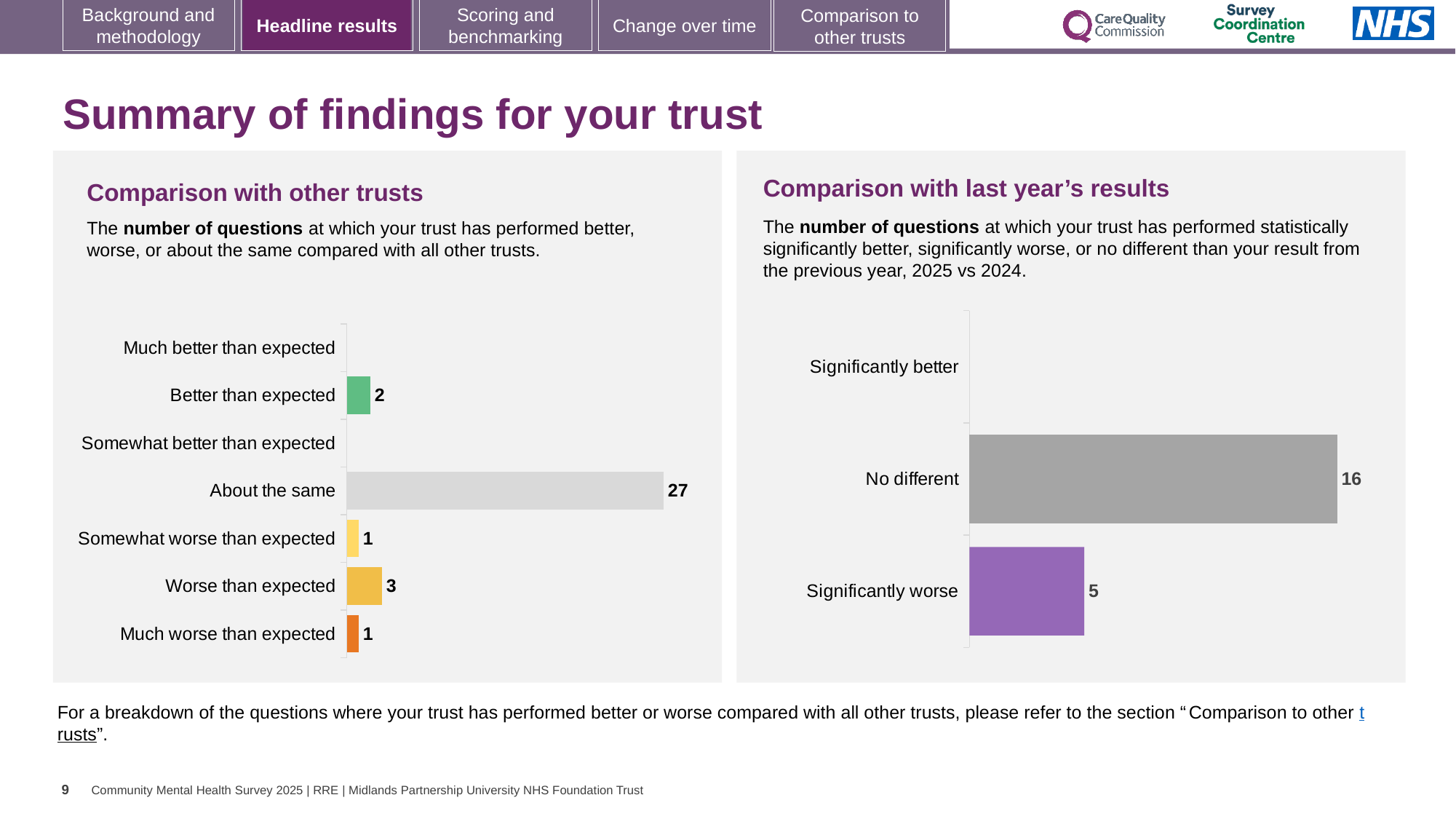
In the 'Comparison with last year's results' chart, what is the value for 'Significantly worse'? 5 In the 'Comparison with other trusts' chart, which category has the highest value? About the same In the 'Comparison with other trusts' chart, which is larger: 'Worse than expected' or 'Better than expected'? Worse than expected In the 'Comparison with other trusts' chart, how many questions are 'About the same'? 27 In the 'Comparison with last year's results' chart, what is the value for 'No different'? 16 What kind of chart is the 'Comparison with last year's results' chart? Bar chart In the 'Comparison with other trusts' chart, what is the value for 'Better than expected'? 2 In the 'Comparison with other trusts' chart, what is the value for 'Worse than expected'? 3 In the 'Comparison with other trusts' chart, what is the difference between 'About the same' and 'Worse than expected'? 24 In the 'Comparison with last year's results' chart, what is the difference between 'No different' and 'Significantly worse'? 11 In the 'Comparison with last year's results' chart, what colour is the 'Significantly worse' bar? Purple How many categories are listed on the y axis of the 'Comparison with other trusts' chart? 7